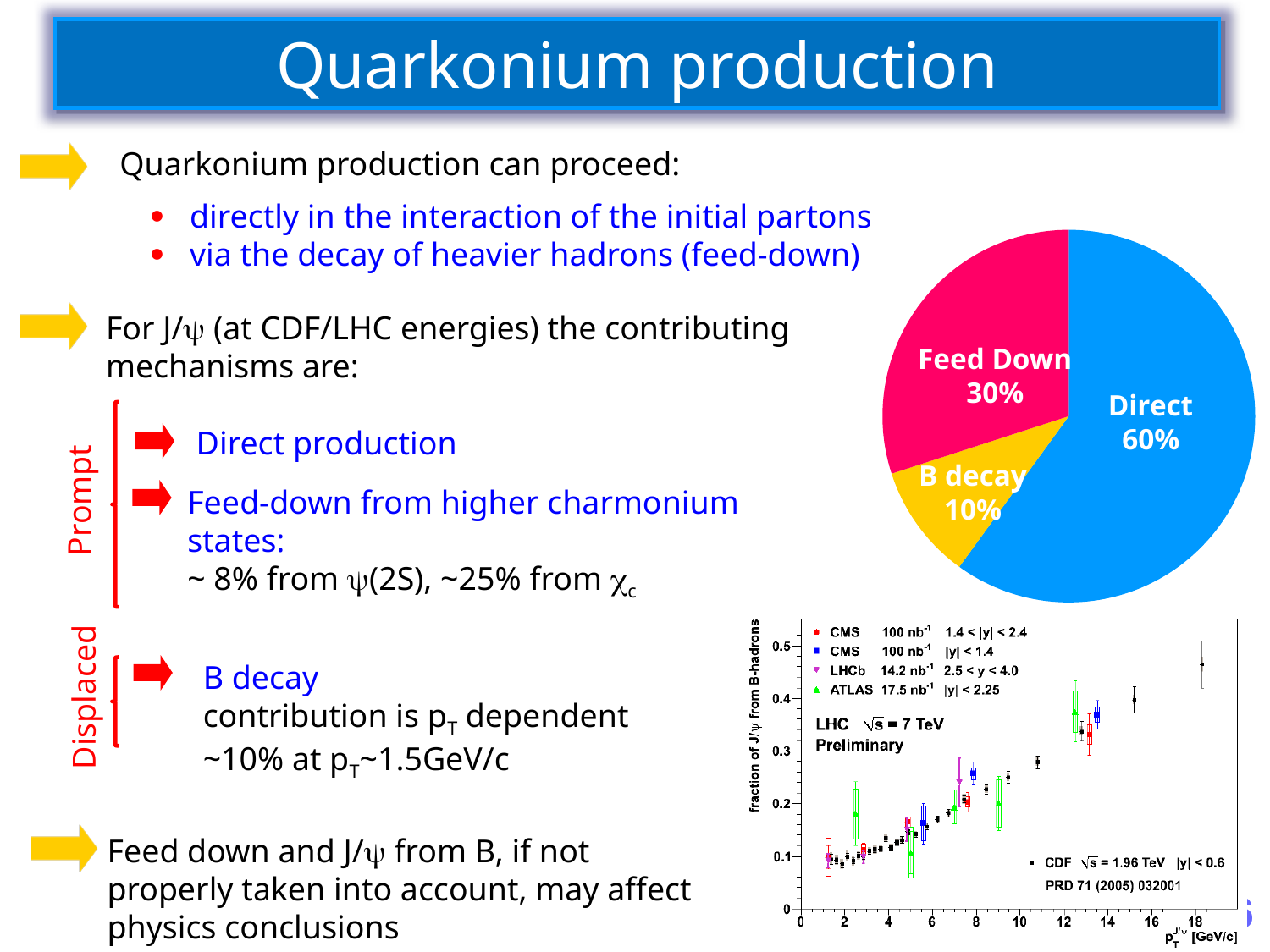
In the pie chart, what share is labelled for Feed Down? 30% In the pie chart, what is the difference between the Direct share and the Feed Down share? 30% In the lower-right plot of the fraction of J/ψ from B-hadrons, does the fraction rise or fall as pT increases? Rises In the lower-right plot, what centre-of-mass energy is stated for the LHC data? √s = 7 TeV What kind of chart is the chart in the upper right of the slide? Pie chart In the pie chart, which is larger, Feed Down or B decay? Feed Down In the pie chart, what share is labelled for B decay? 10% In the pie chart, which slice is the largest? Direct How many slices does the pie chart have? 3 In the lower-right plot of the fraction of J/ψ from B-hadrons, is the CDF value at the highest pT (around 18 GeV/c) greater or less than 0.4? greater In the pie chart, which slice is the smallest? B decay In the pie chart, what share is labelled for Direct? 60%